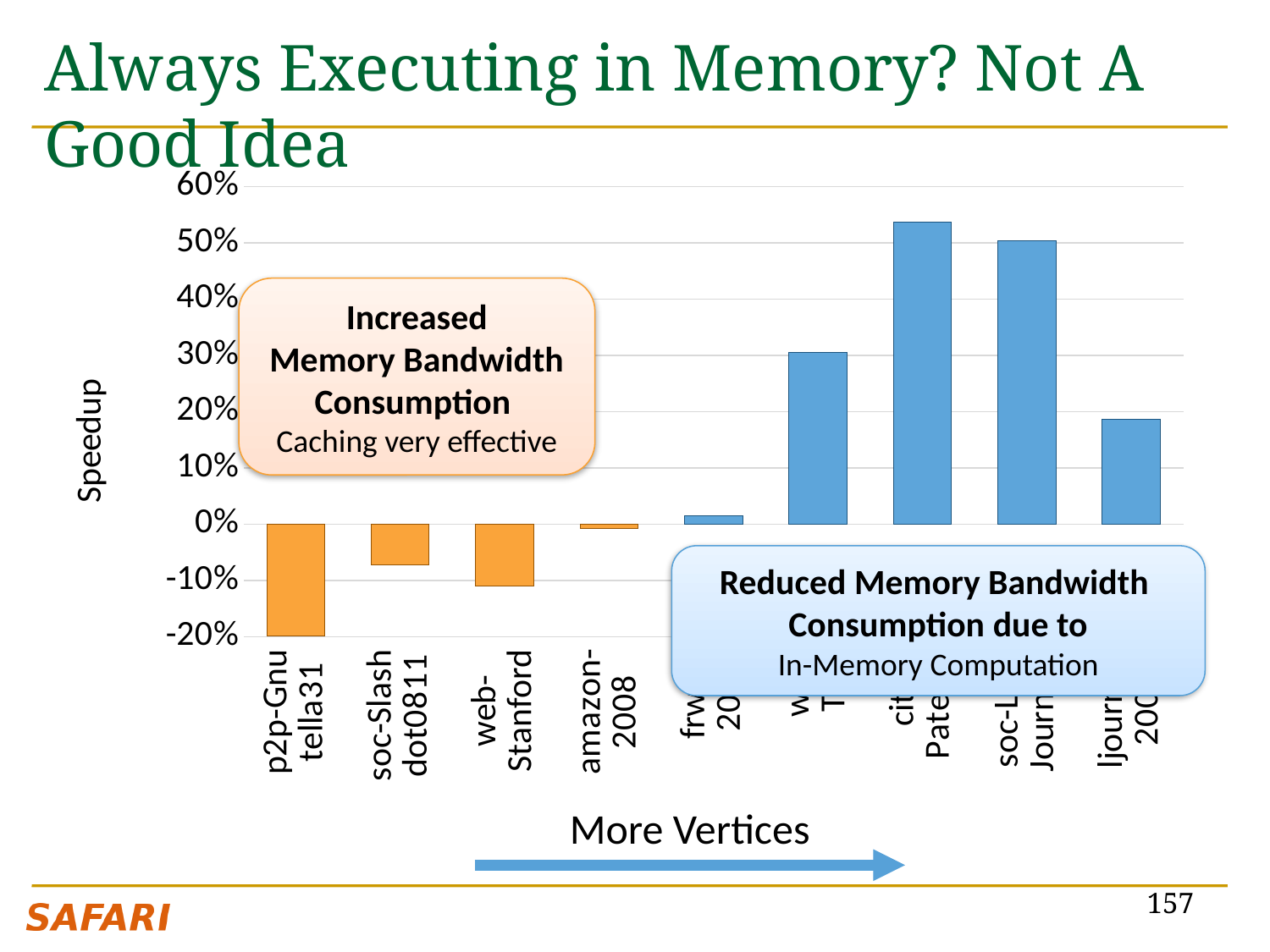
Which has the higher speedup, soc-Slashdot0811 or web-Stanford? soc-Slashdot0811 Moving from left to right along the x axis (toward more vertices), do the speedup values generally rise or fall? rise What is the label of the vertical axis of the chart? Speedup Is the speedup for web-Stanford greater or less than 0%? less What kind of chart is shown on the slide? bar chart Which has the higher speedup, p2p-Gnutella31 or amazon-2008? amazon-2008 How many bars (categories) are plotted in the chart? 9 Is the speedup for soc-Slashdot0811 greater or less than -10%? greater Is the speedup for p2p-Gnutella31 greater or less than -10%? less Which category has the lowest speedup in the chart? p2p-Gnutella31 How many categories have a negative speedup in the chart? 4